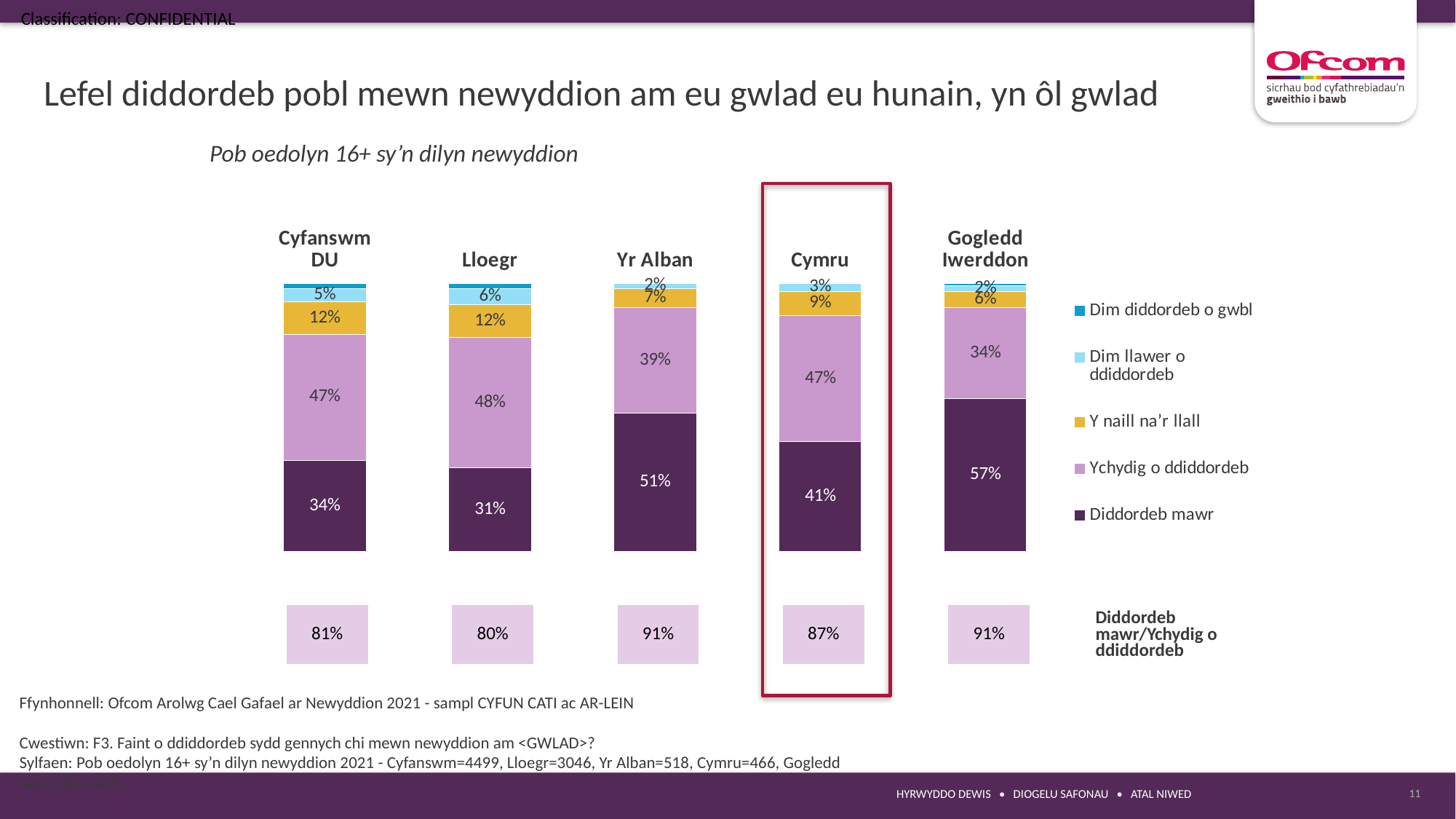
How many series does the legend list? 5 Which country is highlighted with a red outline box on the chart? Cymru Which is larger: the 'Ychydig o ddiddordeb' value for Yr Alban or for Gogledd Iwerddon? Yr Alban What is the difference between the 'Diddordeb mawr' values for Yr Alban and Cyfanswm DU? 17% What is the 'Ychydig o ddiddordeb' value for Lloegr? 48% Which country has the lowest 'Diddordeb mawr' value? Lloegr How many countries/categories are plotted along the x axis? 5 What is the combined 'Diddordeb mawr/Ychydig o ddiddordeb' figure shown for Cymru? 87% Which country has the highest 'Diddordeb mawr' value? Gogledd Iwerddon What is the 'Y naill na'r llall' value for Yr Alban? 7% What is the 'Diddordeb mawr' value for Cymru? 41% What kind of chart is shown on the slide? Stacked bar chart